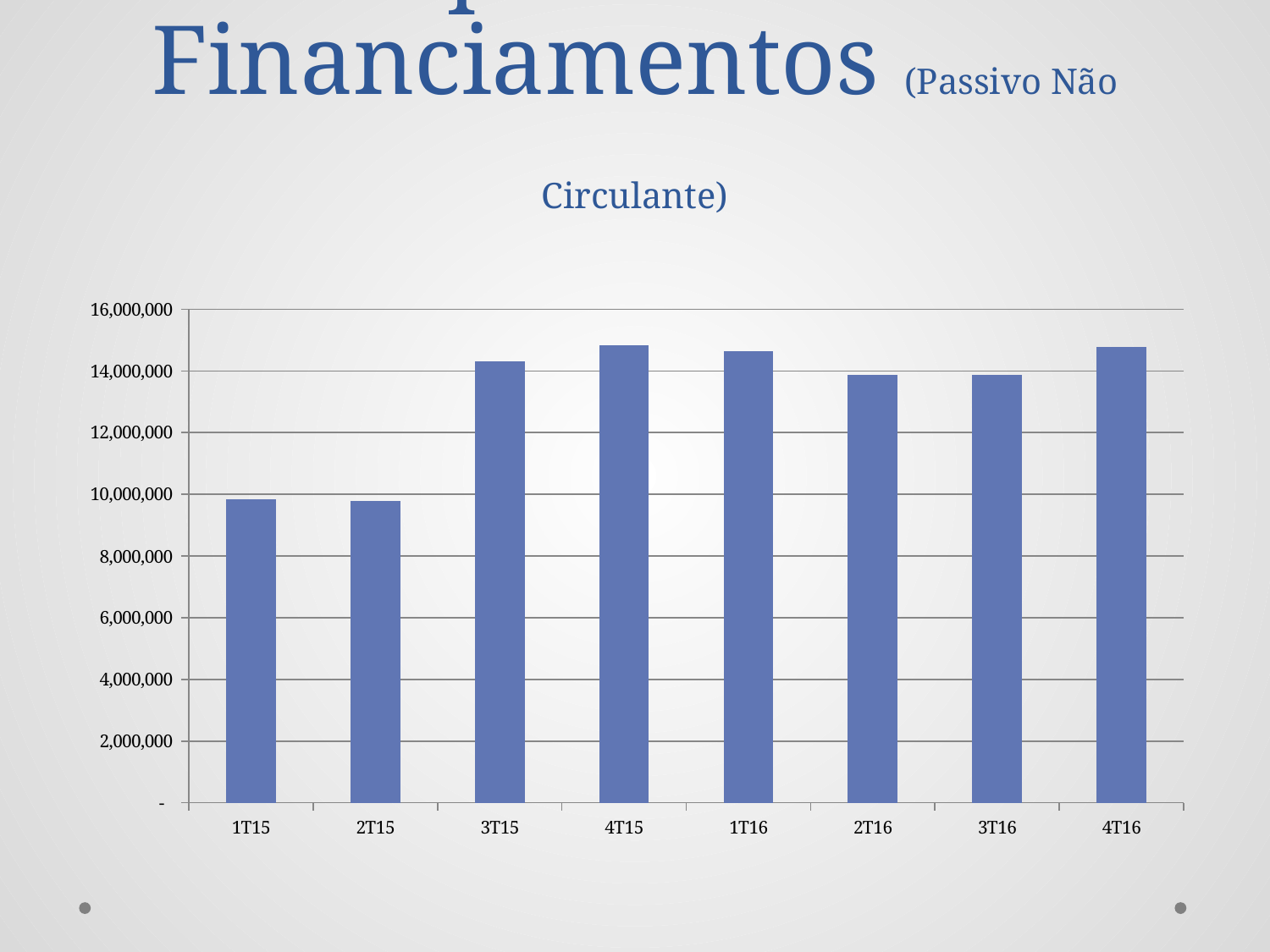
Is the value for 4T16 greater or less than 12,000,000? greater Which is larger, the value for 2T15 or the value for 3T15? 3T15 Is the value for 4T15 greater or less than 14,000,000? greater What is the first label on the x axis of the chart? 1T15 What kind of chart is shown on the slide? bar chart Does the value rise or fall from 2T15 to 3T15? rise Is the value for 2T16 greater or less than 14,000,000? less Which is larger, the value for 4T15 or the value for 2T16? 4T15 How many quarters are plotted on the x axis of the chart? 8